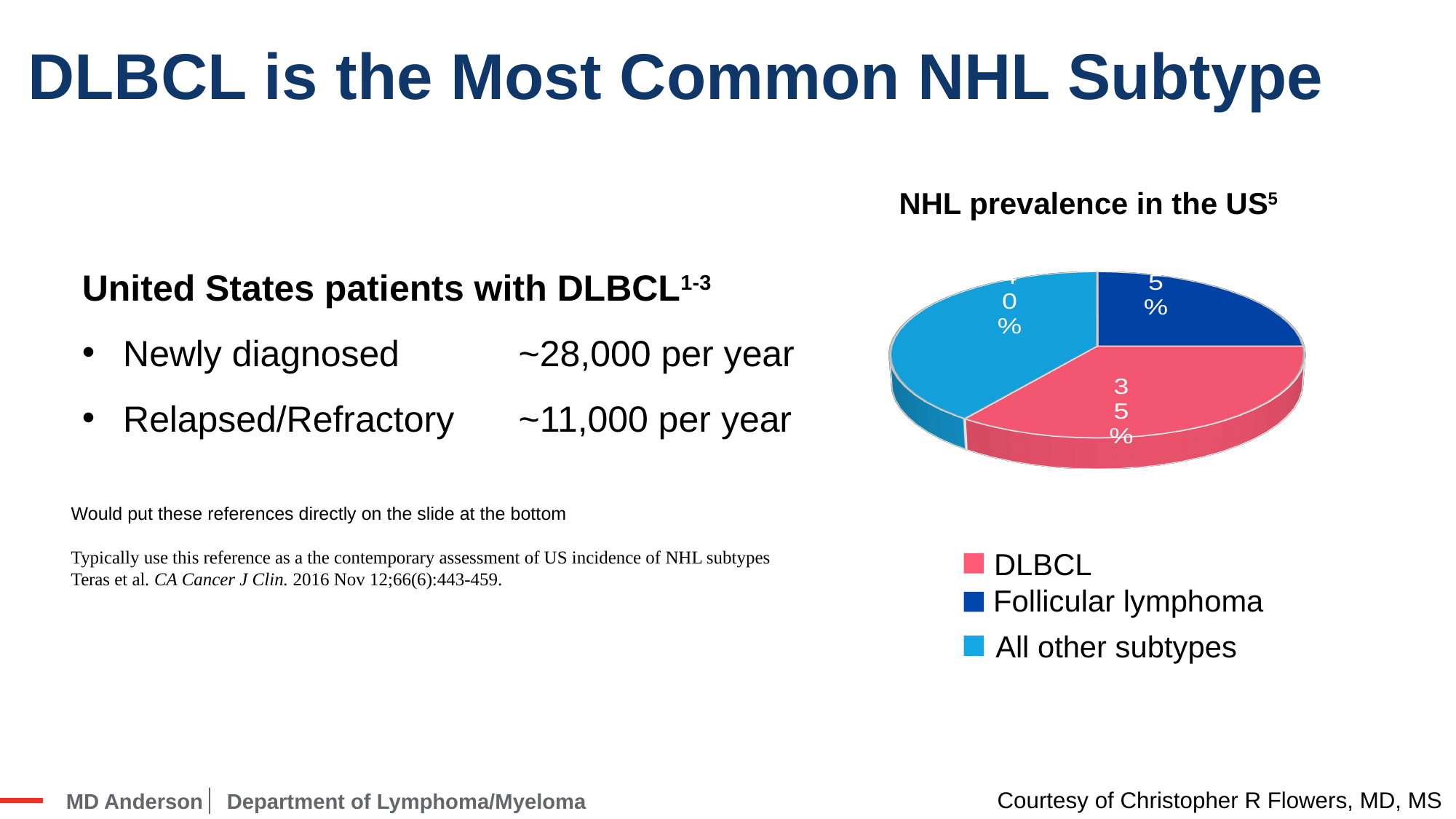
Which slice is larger, DLBCL or Follicular lymphoma? DLBCL What share of the pie is labelled for the DLBCL slice? 35% How many slices does the pie chart have? 3 What is the title of the chart? NHL prevalence in the US Which category has the smallest slice of the pie? Follicular lymphoma What colour is the DLBCL slice in the pie chart? pink What type of chart is shown on the slide? pie chart What percentage of the pie does DLBCL account for? 35% Which slice is larger, All other subtypes or Follicular lymphoma? All other subtypes How many entries does the chart legend list? 3